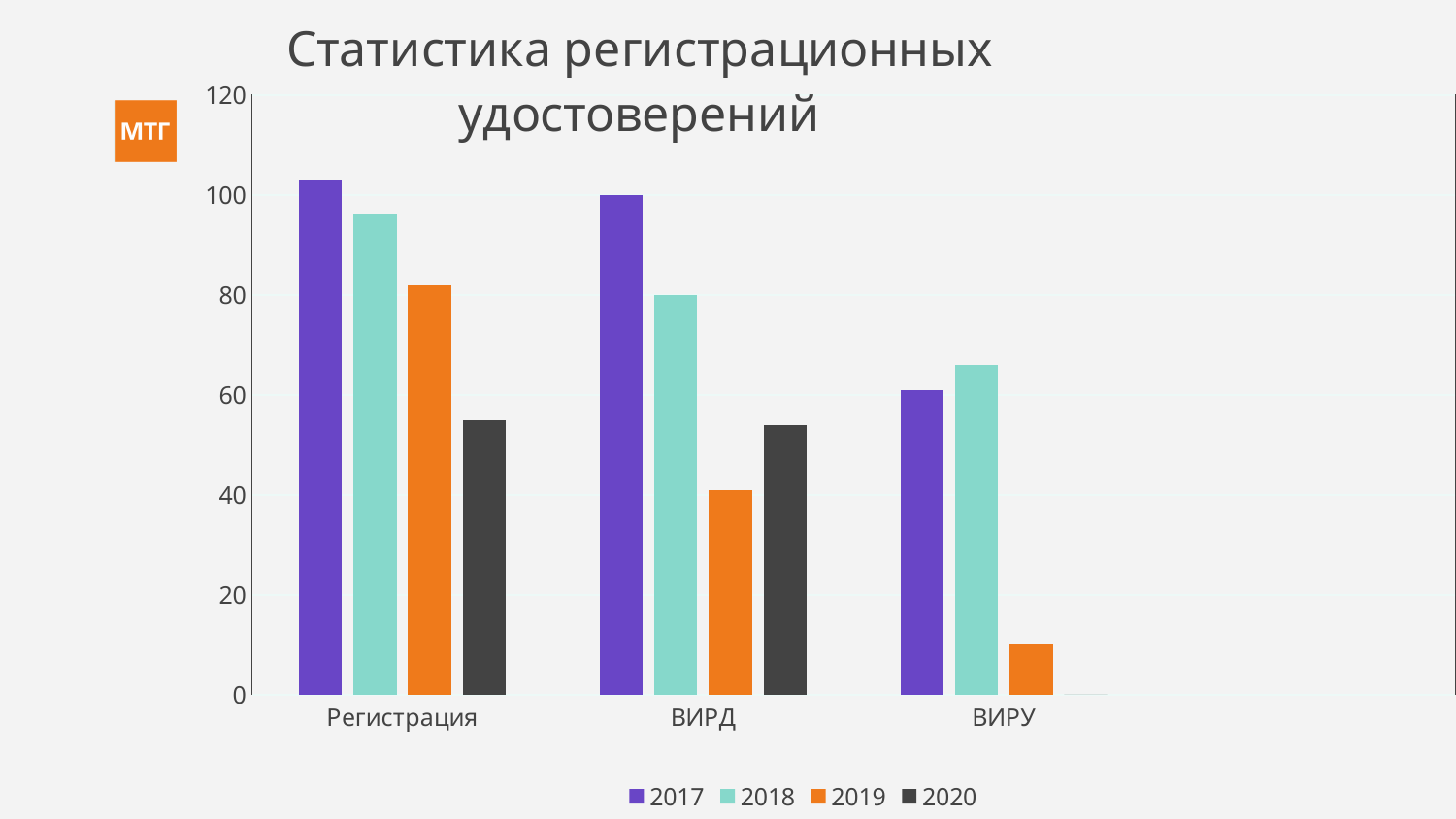
Which category has the highest value for 2017? Регистрация Which series is shown in orange in the legend? 2019 What is the title of the chart? Статистика регистрационных удостоверений How many categories are shown on the x axis? 3 What kind of chart is shown on the slide? bar chart How many series does the legend list? 4 Which category has the lowest value for 2019? ВИРУ Is the value for 2019 in the ВИРУ category greater or less than 20? less In the ВИРД category, which is larger: the value for 2018 or the value for 2019? 2018 Is the value for 2017 in the Регистрация category greater or less than 100? greater Is the value for 2020 in the Регистрация category greater or less than 60? less